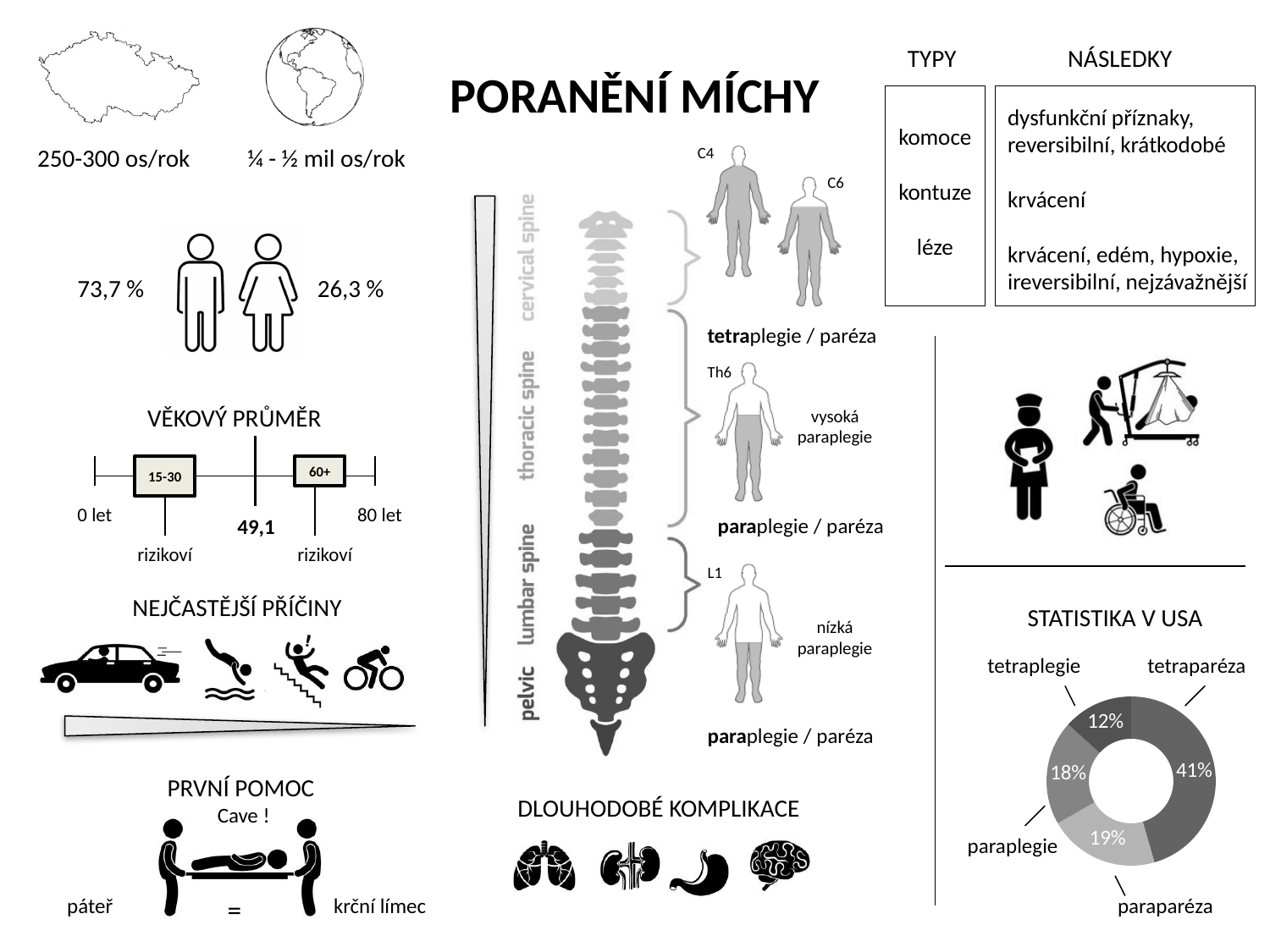
In the STATISTIKA V USA chart, which is larger, the share for paraparéza or the share for paraplegie? paraparéza In the STATISTIKA V USA chart, how many categories are shown? 4 In the STATISTIKA V USA chart, what is the combined percentage of tetraplegie and paraplegie? 30% In the STATISTIKA V USA chart, which category has the smallest share? tetraplegie What is the title of the chart in the bottom-right corner of the slide? STATISTIKA V USA In the STATISTIKA V USA chart, which category has the largest share? tetraparéza In the STATISTIKA V USA chart, what percentage is shown for tetraplegie? 12% In the STATISTIKA V USA chart, what is the difference in percentage points between tetraparéza and tetraplegie? 29 What kind of chart is the STATISTIKA V USA chart? doughnut chart In the STATISTIKA V USA chart, what percentage is shown for paraparéza? 19% In the STATISTIKA V USA chart, what percentage is shown for tetraparéza? 41% In the STATISTIKA V USA chart, what percentage is shown for paraplegie? 18%